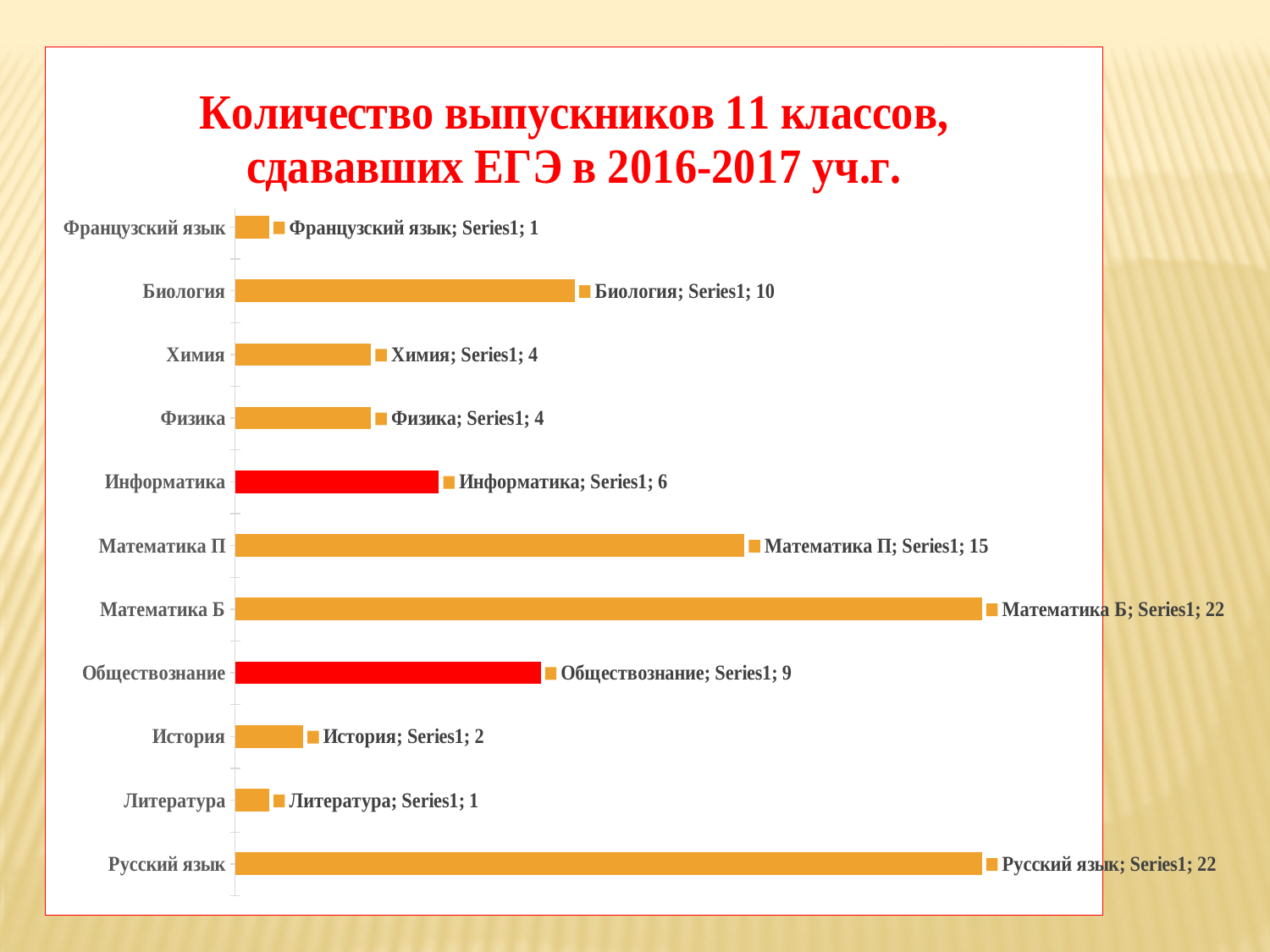
Which bars are coloured red rather than orange? Информатика and Обществознание Which categories have the highest value? Математика Б and Русский язык Which categories have the lowest value? Французский язык and Литература What is the value for Математика П? 15 What is the difference between the values for История and Химия? 2 What kind of chart is shown on the slide? Bar chart What is the difference between the values for Математика Б and Математика П? 7 What is the value for Информатика? 6 What is the value for Биология? 10 What is the value for Обществознание? 9 How many categories are shown in the chart? 11 Which is larger, the value for Биология or the value for Обществознание? Биология